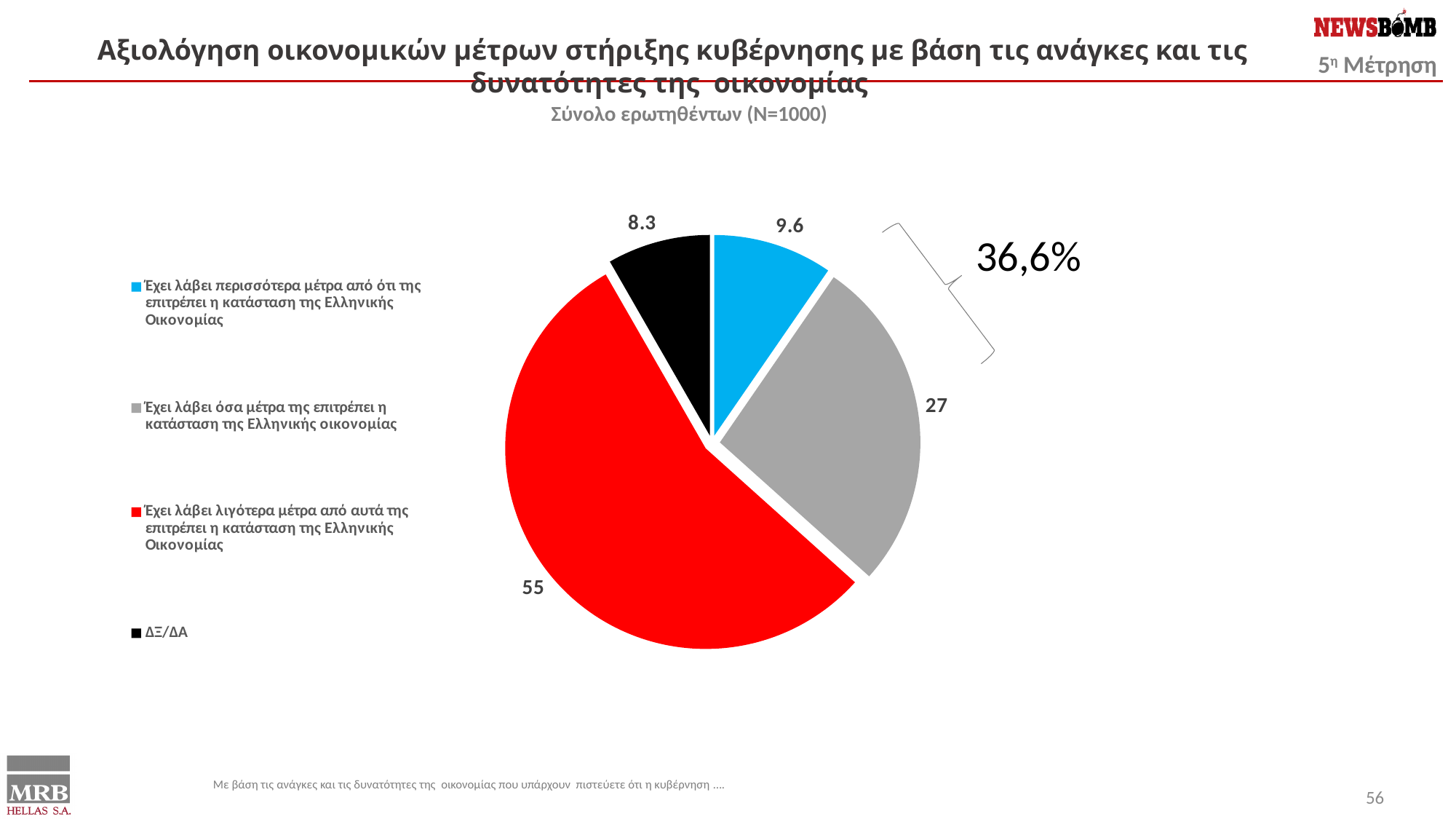
What colour is the slice for 'Έχει λάβει λιγότερα μέτρα από αυτά της επιτρέπει η κατάσταση της Ελληνικής Οικονομίας'? red What is the difference between the value for 'Έχει λάβει λιγότερα μέτρα...' (55) and the value for 'Έχει λάβει όσα μέτρα...' (27)? 28 Which category has the largest slice of the pie? Έχει λάβει λιγότερα μέτρα από αυτά της επιτρέπει η κατάσταση της Ελληνικής Οικονομίας What is the value of the slice for 'Έχει λάβει λιγότερα μέτρα από αυτά της επιτρέπει η κατάσταση της Ελληνικής Οικονομίας'? 55 What is the value of the slice for 'Έχει λάβει όσα μέτρα της επιτρέπει η κατάσταση της Ελληνικής οικονομίας'? 27 Which is larger: the slice for 'Έχει λάβει περισσότερα μέτρα...' or the ΔΞ/ΔΑ slice? Έχει λάβει περισσότερα μέτρα από ότι της επιτρέπει η κατάσταση της Ελληνικής Οικονομίας How many slices does the pie chart have? 4 What is the value of the ΔΞ/ΔΑ slice? 8.3 What combined percentage is shown by the bracket next to the blue and grey slices? 36,6% What kind of chart is shown on the slide? pie chart What is the value of the slice for 'Έχει λάβει περισσότερα μέτρα από ότι της επιτρέπει η κατάσταση της Ελληνικής Οικονομίας'? 9.6 Which category has the smallest slice of the pie? ΔΞ/ΔΑ